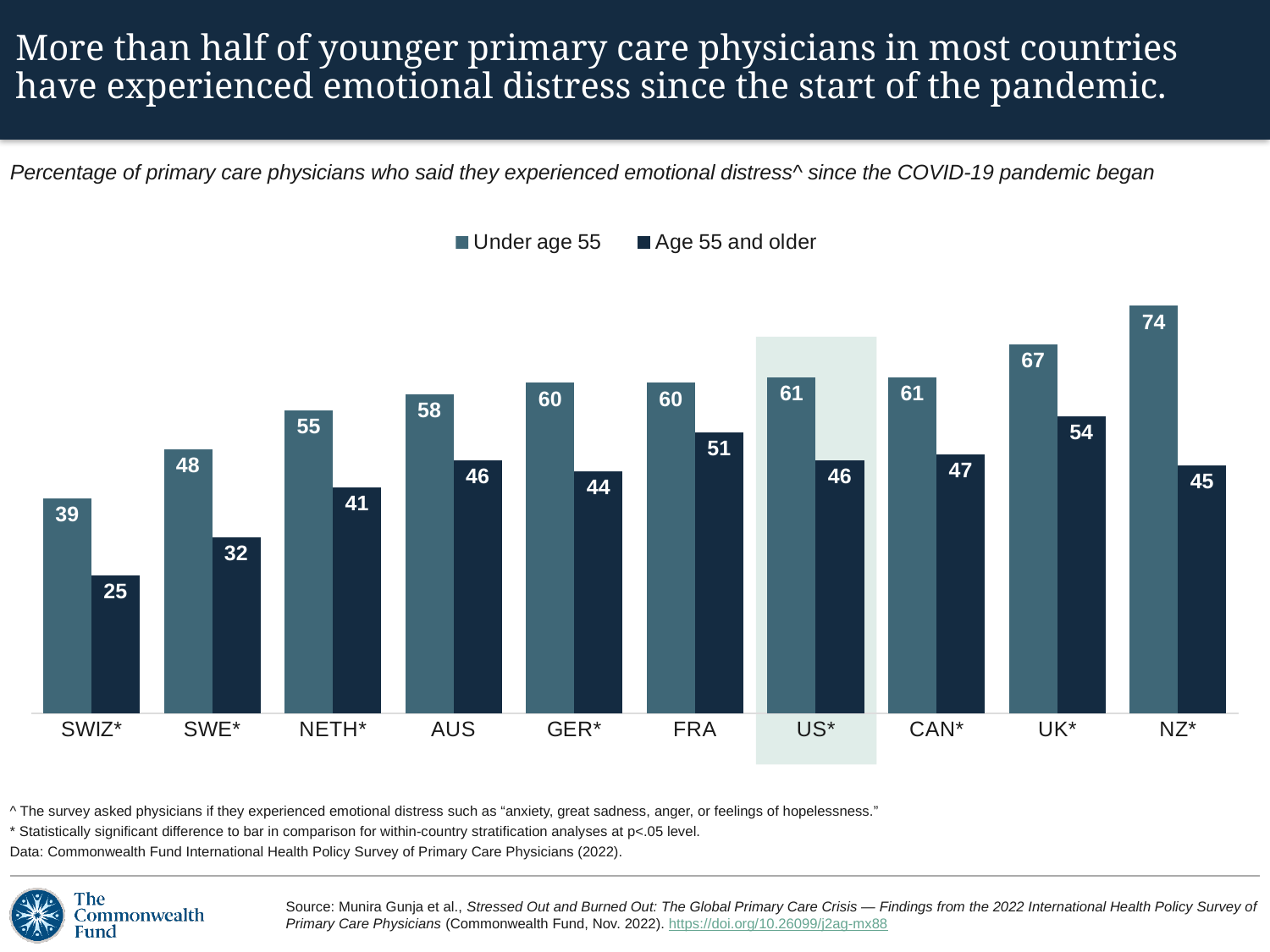
Which country has the highest value for Under age 55? NZ* What is the value for Under age 55 in SWE*? 48 Which is larger: the Under age 55 value for UK* or the Under age 55 value for CAN*? UK* Which country has the lowest value for Age 55 and older? SWIZ* What is the difference between the Under age 55 and Age 55 and older values for NZ*? 29 What kind of chart is shown on the slide? Bar chart What is the value for Under age 55 in NZ*? 74 What is the value for Age 55 and older in US*? 46 What is the value for Age 55 and older in SWIZ*? 25 How many countries are shown on the x axis? 10 How many series does the legend list? 2 Which country is highlighted with a shaded background in the chart? US*